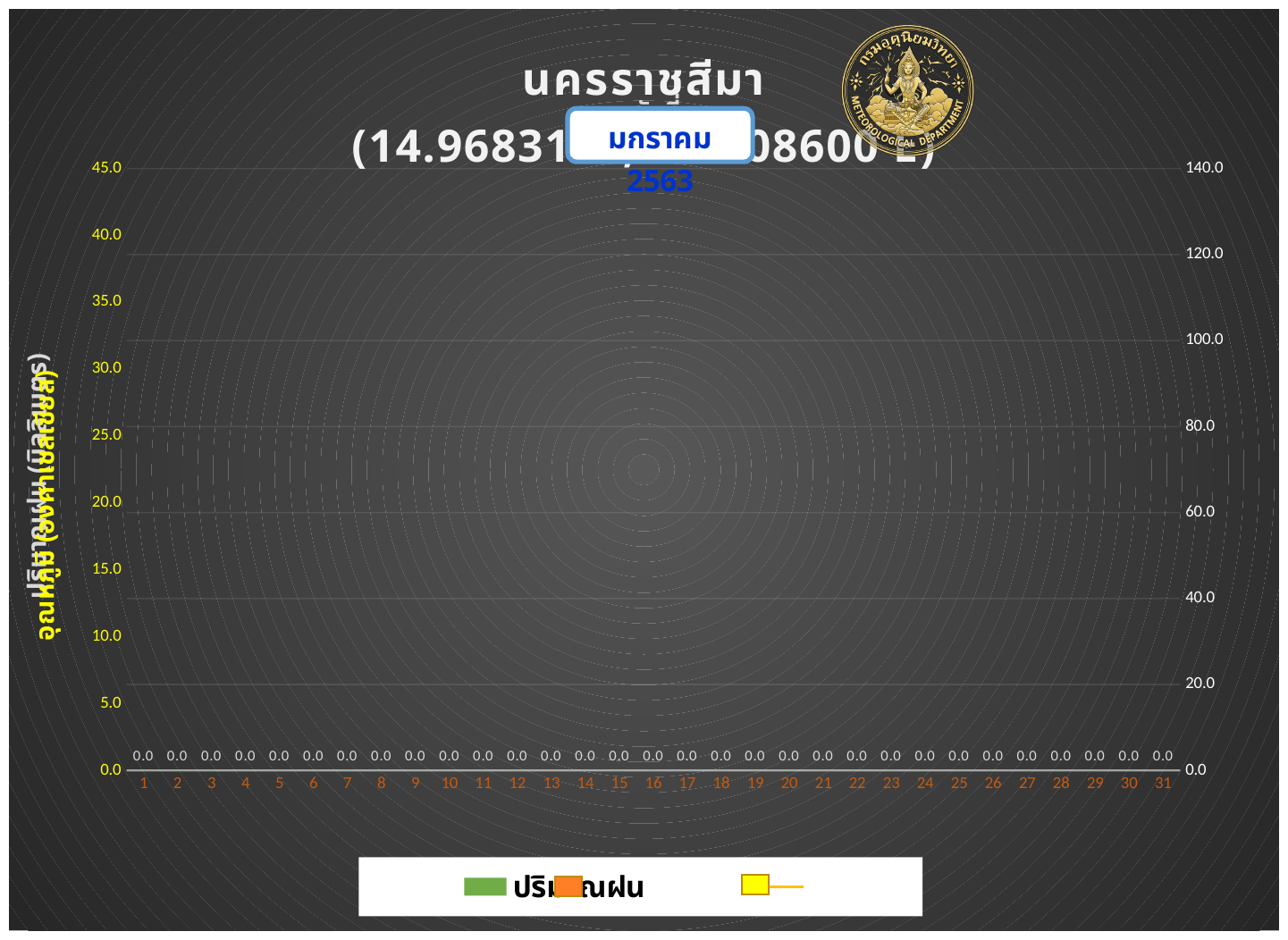
What is the data label shown for day 15 on the x axis? 0.0 What is the data label shown for day 31 on the x axis? 0.0 Do the labelled values rise, fall, or stay flat across the days on the x axis? stay flat What is the difference between the labelled values for day 10 and day 20? 0.0 What is the data label shown for day 1 on the x axis? 0.0 What is the highest tick value shown on the left vertical axis? 45.0 What is the highest tick value shown on the right vertical axis? 140.0 How many categories (days) are shown along the x axis? 31 How many colour swatches does the legend show? 3 Is the labelled value for day 5 greater or less than 5.0 on the left axis? less